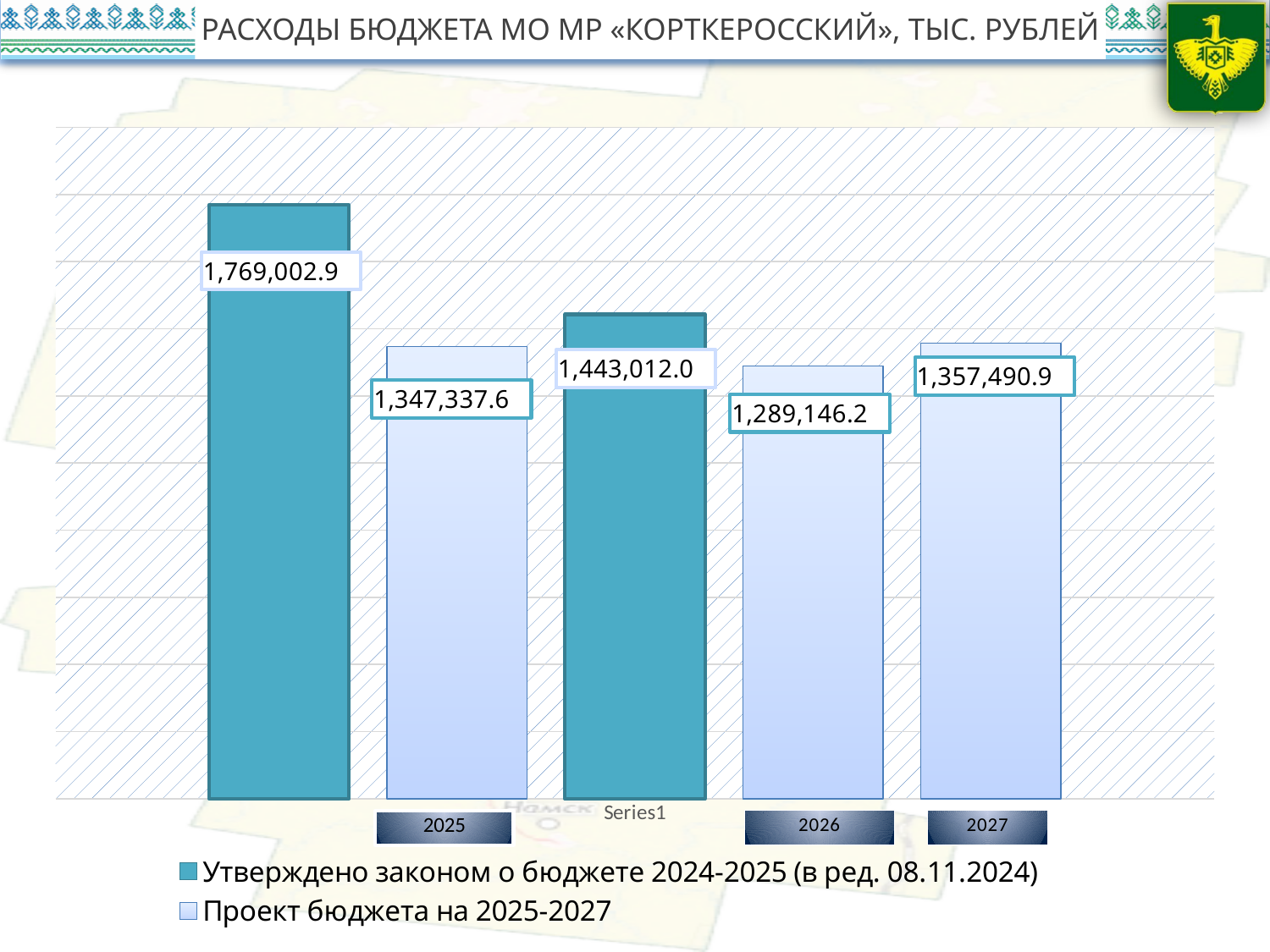
What is the difference between the two dark teal bars (1,769,002.9 and 1,443,012.0)? 325,990.9 Which is larger: the light blue bar with value 1,347,337.6 or the 2027 bar with value 1,357,490.9? 1,357,490.9 (2027) What is the highest value shown on any bar in the chart? 1,769,002.9 What is the value of the second (shorter) dark teal bar? 1,443,012.0 What type of chart is shown on the slide? Bar chart What is the lowest value shown on any bar in the chart? 1,289,146.2 Which legend entry corresponds to the dark teal bars? Утверждено законом о бюджете 2024-2025 (в ред. 08.11.2024) What is the value of the bar labelled 2027? 1,357,490.9 What is the value of the tallest dark teal bar (series 'Утверждено законом о бюджете 2024-2025')? 1,769,002.9 How many series does the legend list? 2 What is the difference between the 2027 bar (1,357,490.9) and the 2026 light blue bar (1,289,146.2)? 68,344.7 How many bars are plotted in the chart? 5